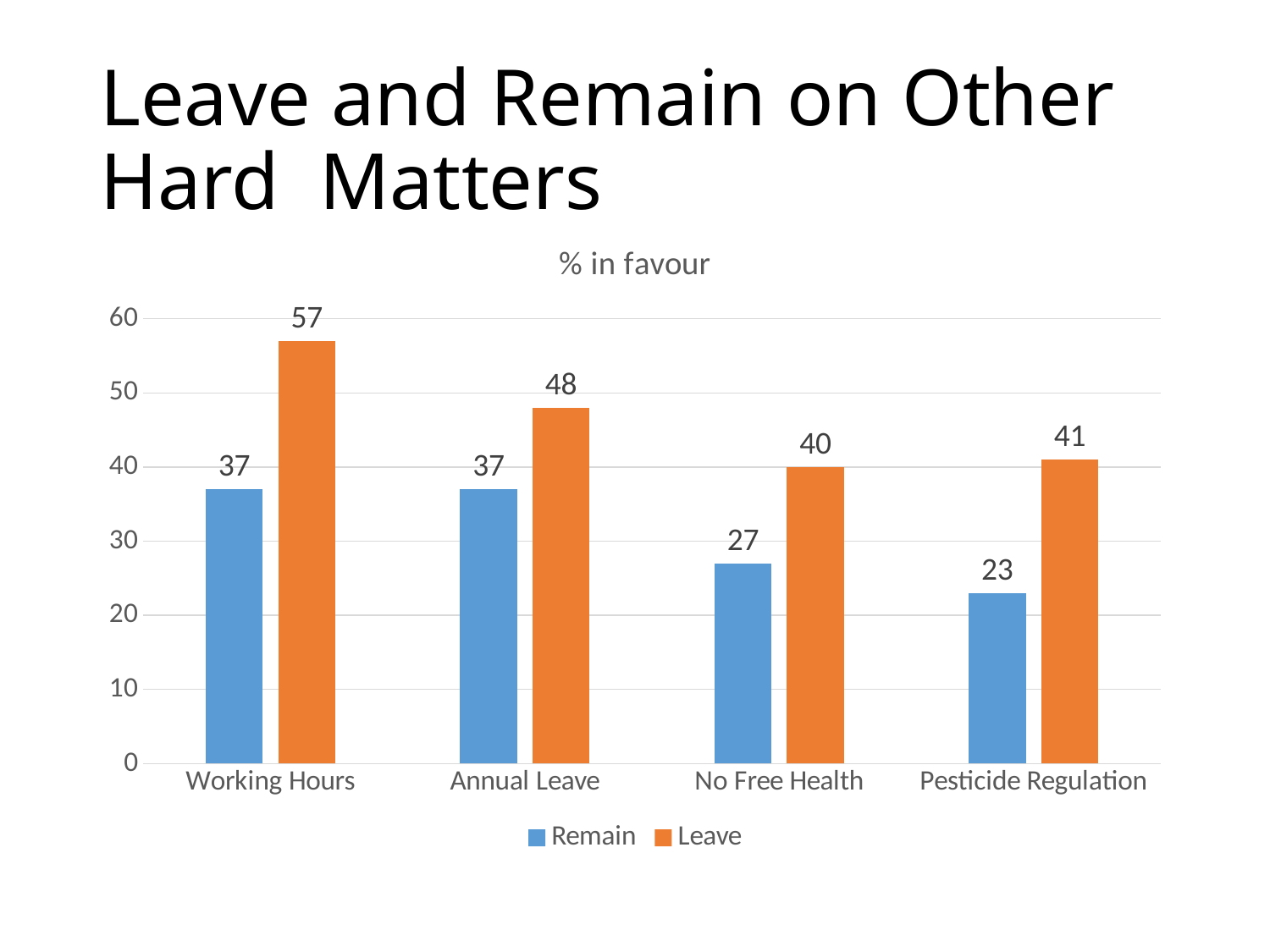
How many categories are shown on the x axis? 4 Which category has the highest Leave value? Working Hours How many series does the legend list? 2 Which category has the lowest Remain value? Pesticide Regulation What is the difference between the Leave values for Annual Leave and No Free Health? 8 What is the Remain value for No Free Health? 27 Which is larger for Pesticide Regulation, the Remain value or the Leave value? Leave What kind of chart is shown on the slide? Bar chart What is the Leave value for Working Hours? 57 What is the Remain value for Pesticide Regulation? 23 What is the difference between the Leave and Remain values for Working Hours? 20 What is the title of the chart? % in favour